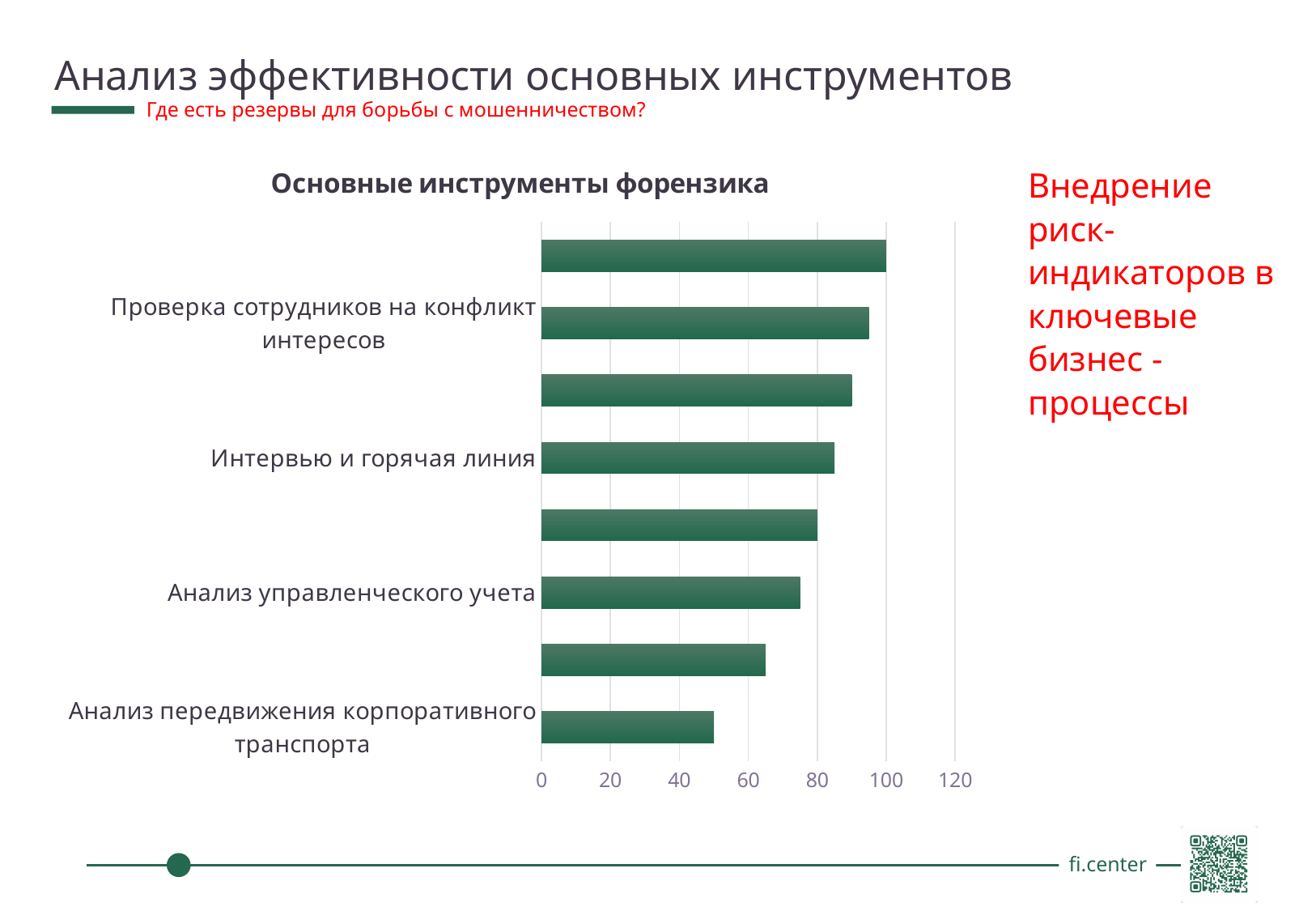
Is the value for "Интервью и горячая линия" greater or less than 60? greater Is the value for "Анализ передвижения корпоративного транспорта" greater or less than 60? less Do the bar values increase or decrease going from the top of the chart to the bottom? decrease Which has the larger value: "Интервью и горячая линия" or "Анализ управленческого учета"? Интервью и горячая линия What is the title of the chart? Основные инструменты форензика Among the labelled categories, which has the lowest value? Анализ передвижения корпоративного транспорта How many bars are plotted in the chart? 8 Which has the larger value: "Анализ передвижения корпоративного транспорта" or "Проверка сотрудников на конфликт интересов"? Проверка сотрудников на конфликт интересов What kind of chart is shown on the slide? bar chart What is the highest value shown on the horizontal axis? 120 Is the value for "Анализ управленческого учета" greater or less than 80? less